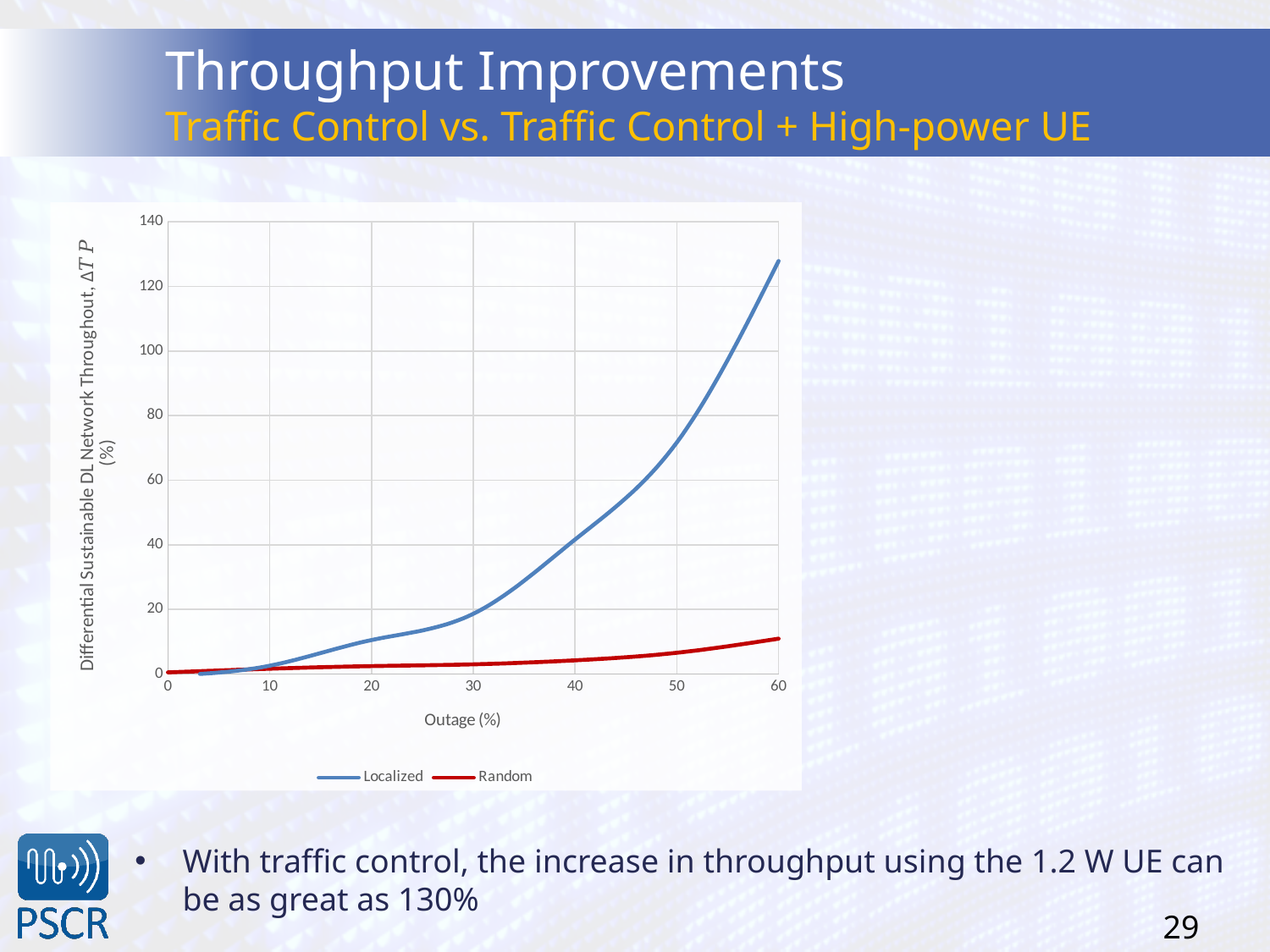
Which series reaches the highest value on the chart? Localized Does the Random series rise or fall as Outage increases along the x axis? rise How many series does the chart's legend list? 2 What are the two series named in the chart's legend? Localized and Random Does the Localized series rise or fall as Outage increases along the x axis? rise What kind of chart is shown on the slide? line chart At an Outage of 60%, which series has the larger value, Localized or Random? Localized Is the value of the Localized series at an Outage of 60% greater or less than 120? greater Is the value of the Localized series at an Outage of 50% greater or less than 60? greater What is the label of the x axis of the chart? Outage (%) Is the value of the Random series at an Outage of 60% greater or less than 20? less